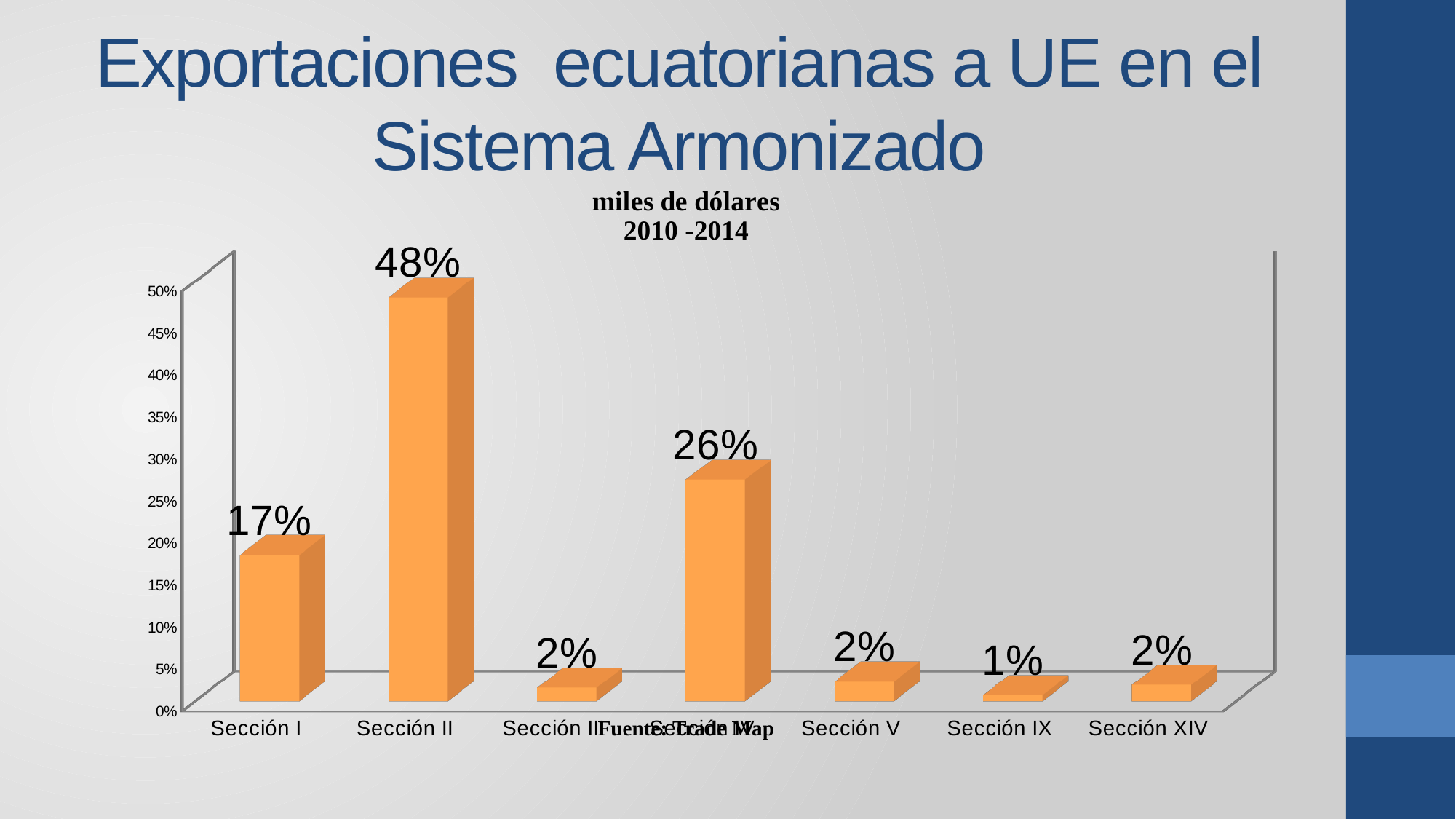
What is the value for Sección I? 17% Which category has the lowest value? Sección IX What is the title of the chart? miles de dólares 2010 -2014 What is the value for Sección XIV? 2% How many categories are shown on the x axis? 7 What kind of chart is shown on the slide? bar chart Which category has the highest value? Sección II Which is larger, the value for Sección I or the value for Sección V? Sección I What is the value for Sección II? 48% What is the difference between the values for Sección II and Sección I? 31% What is the value for Sección V? 2% What is the value for Sección IX? 1%